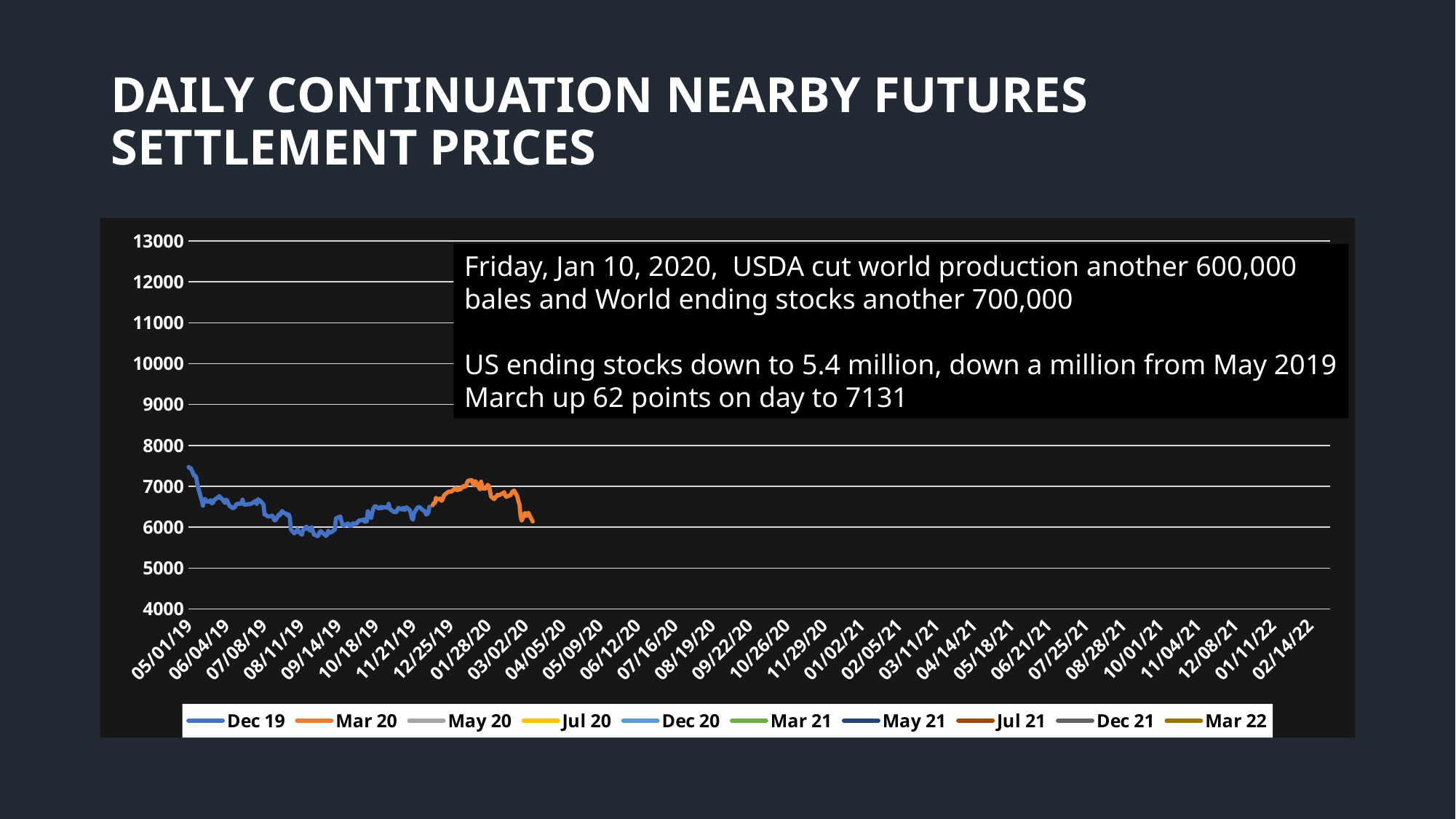
Is the value for Dec 19 at 05/01/19 greater or less than 7000? greater What is the highest value shown on the vertical axis? 13000 Does the Mar 20 series rise or fall from 01/28/20 to 03/02/20? fall How many series does the legend list? 10 What kind of chart is shown on the slide? line chart Which is larger: the Dec 19 value at 05/01/19 or the Mar 20 value at 03/02/20? Dec 19 at 05/01/19 How many of the legend series have data plotted on the chart? 2 Is the value for Dec 19 at 09/14/19 greater or less than 7000? less Which series is plotted in orange? Mar 20 Does the Dec 19 series rise or fall from 05/01/19 to 08/11/19? fall